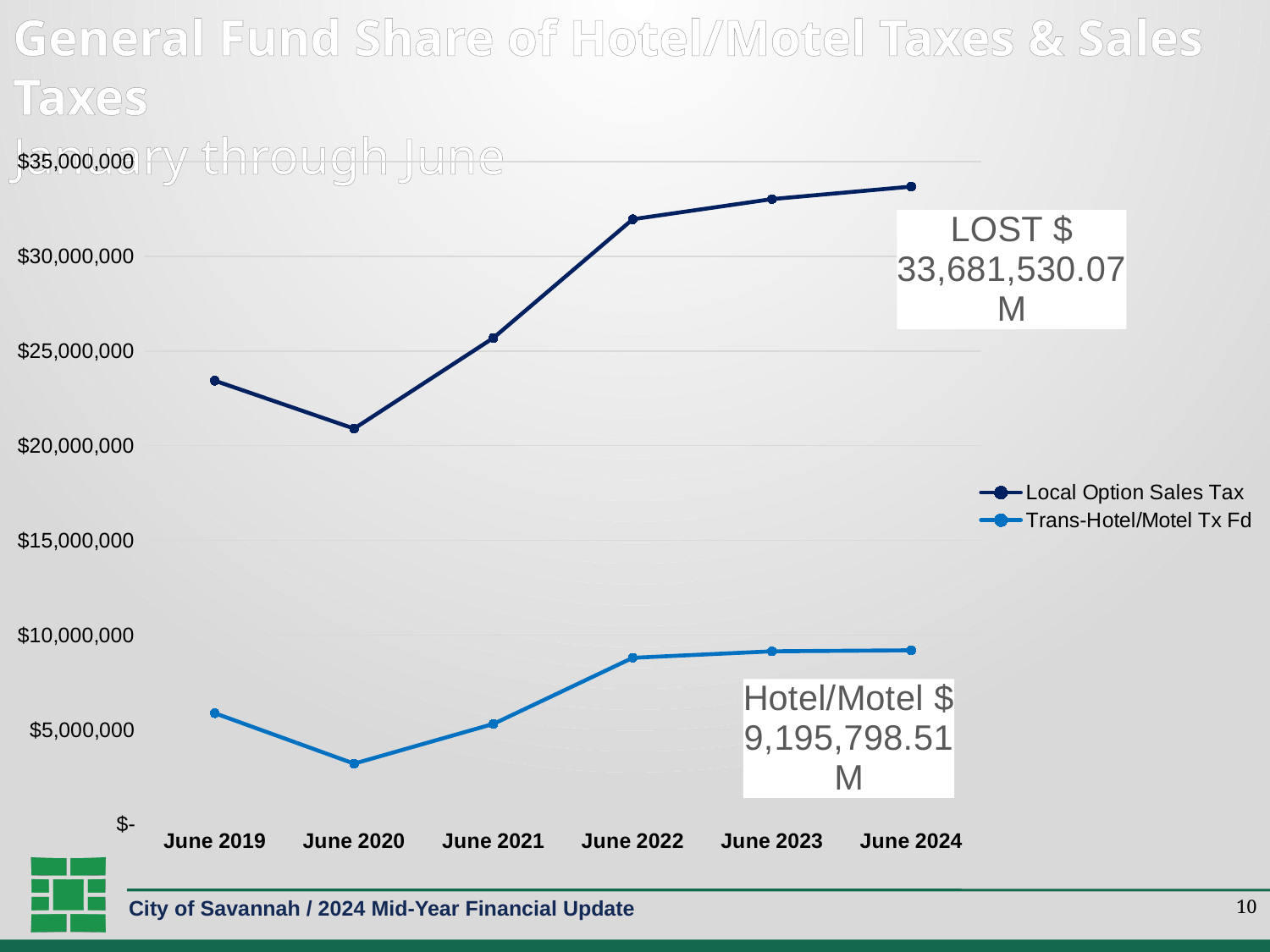
In which year is the Trans-Hotel/Motel Tx Fd value lowest? June 2020 Is the Trans-Hotel/Motel Tx Fd value for June 2020 greater or less than $5,000,000? less Is the Trans-Hotel/Motel Tx Fd value for June 2023 greater or less than $10,000,000? less In which year is the Local Option Sales Tax value lowest? June 2020 How many time points are plotted along the x axis? 6 How many series does the legend list? 2 In which year is the Local Option Sales Tax value highest? June 2024 What kind of chart is shown on the slide? Line chart Is the Local Option Sales Tax value for June 2022 greater or less than $30,000,000? greater Does the Local Option Sales Tax line rise or fall from June 2020 to June 2024? Rises Which series has the larger value in June 2022, Local Option Sales Tax or Trans-Hotel/Motel Tx Fd? Local Option Sales Tax